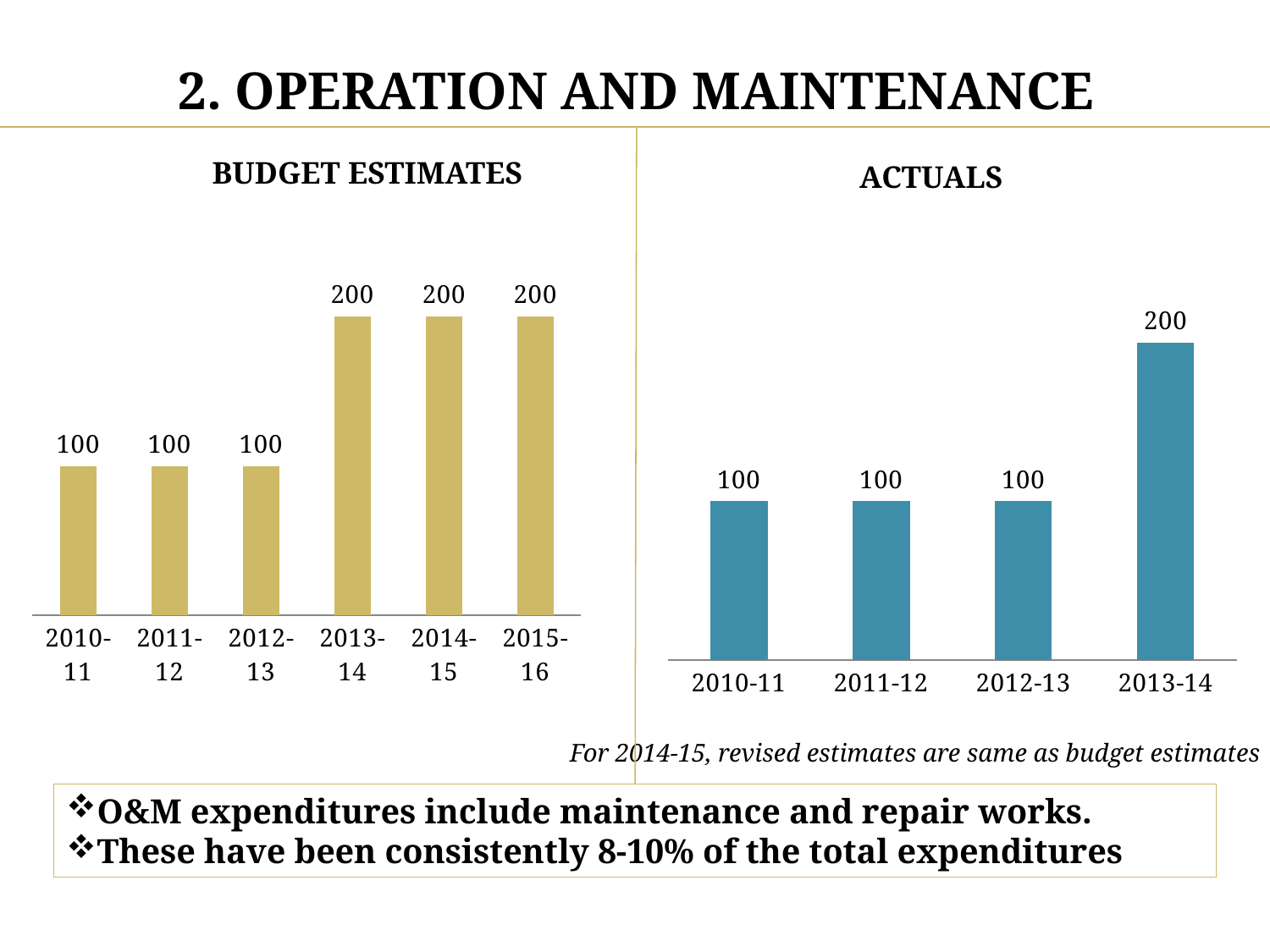
What type of chart is the ACTUALS chart? Bar chart In the BUDGET ESTIMATES chart, what is the value for 2013-14? 200 In the BUDGET ESTIMATES chart, what is the value for 2010-11? 100 In the ACTUALS chart, what is the difference between the values for 2013-14 and 2011-12? 100 In the ACTUALS chart, what is the value for 2013-14? 200 How many years are shown in the BUDGET ESTIMATES chart? 6 In the BUDGET ESTIMATES chart, do the values rise or fall from 2010-11 to 2015-16? Rise In the ACTUALS chart, what is the value for 2012-13? 100 In the ACTUALS chart, which year has the highest value? 2013-14 In the BUDGET ESTIMATES chart, which is larger, the value for 2011-12 or the value for 2014-15? 2014-15 In the BUDGET ESTIMATES chart, what is the difference between the values for 2013-14 and 2012-13? 100 How many years are shown in the ACTUALS chart? 4